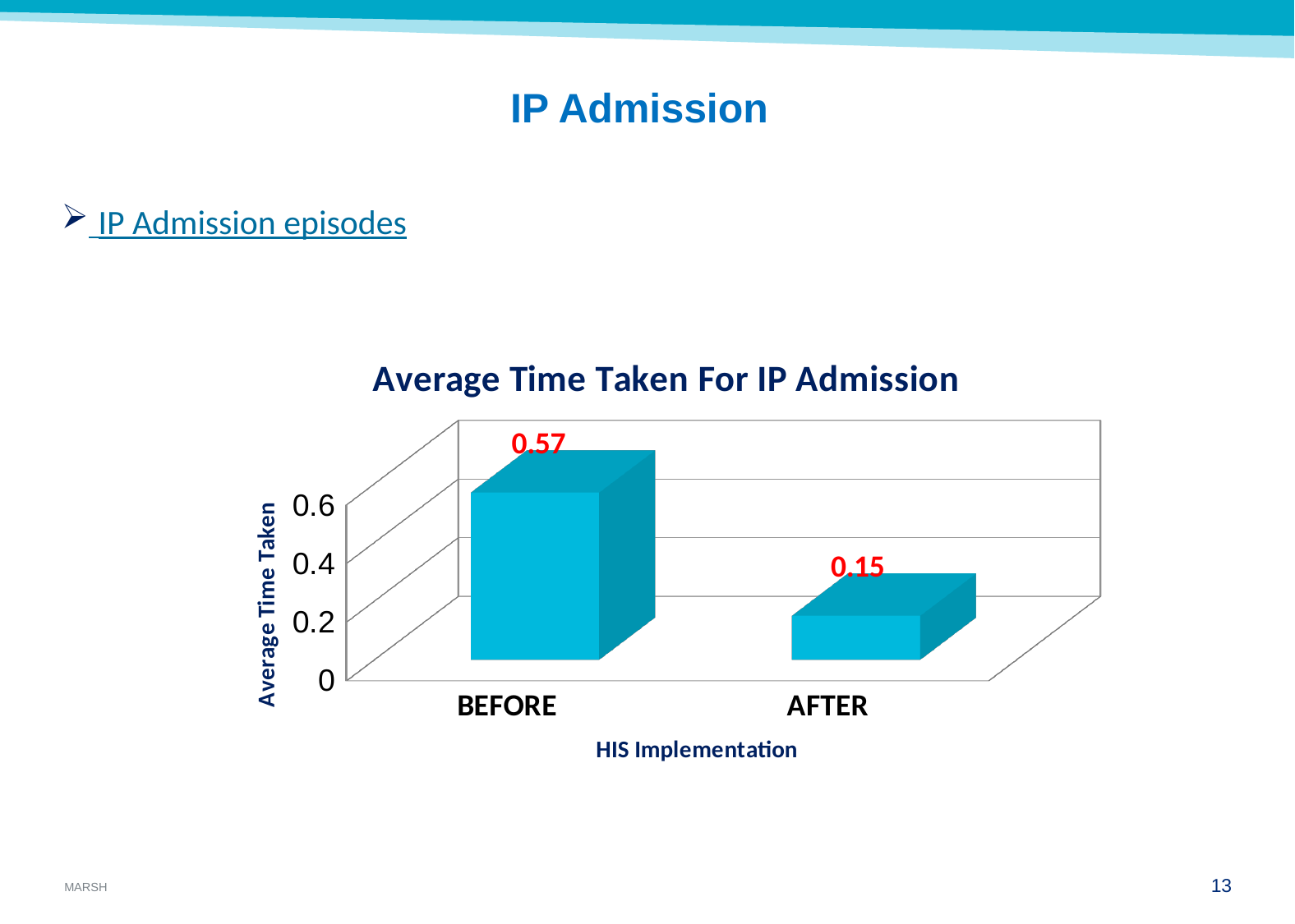
What is the difference between the BEFORE and AFTER values? 0.42 What is the average time taken for IP admission AFTER HIS implementation? 0.15 Which category has the higher average time taken, BEFORE or AFTER? BEFORE Is the value for BEFORE greater or less than 0.4? greater How many categories are shown on the x axis? 2 Which category has the lowest average time taken? AFTER What kind of chart is shown on the slide? Bar chart Do the values rise or fall from BEFORE to AFTER? Fall What is the average time taken for IP admission BEFORE HIS implementation? 0.57 Is the value for AFTER greater or less than 0.2? less What is the label of the x axis? HIS Implementation What is the title of the chart? Average Time Taken For IP Admission